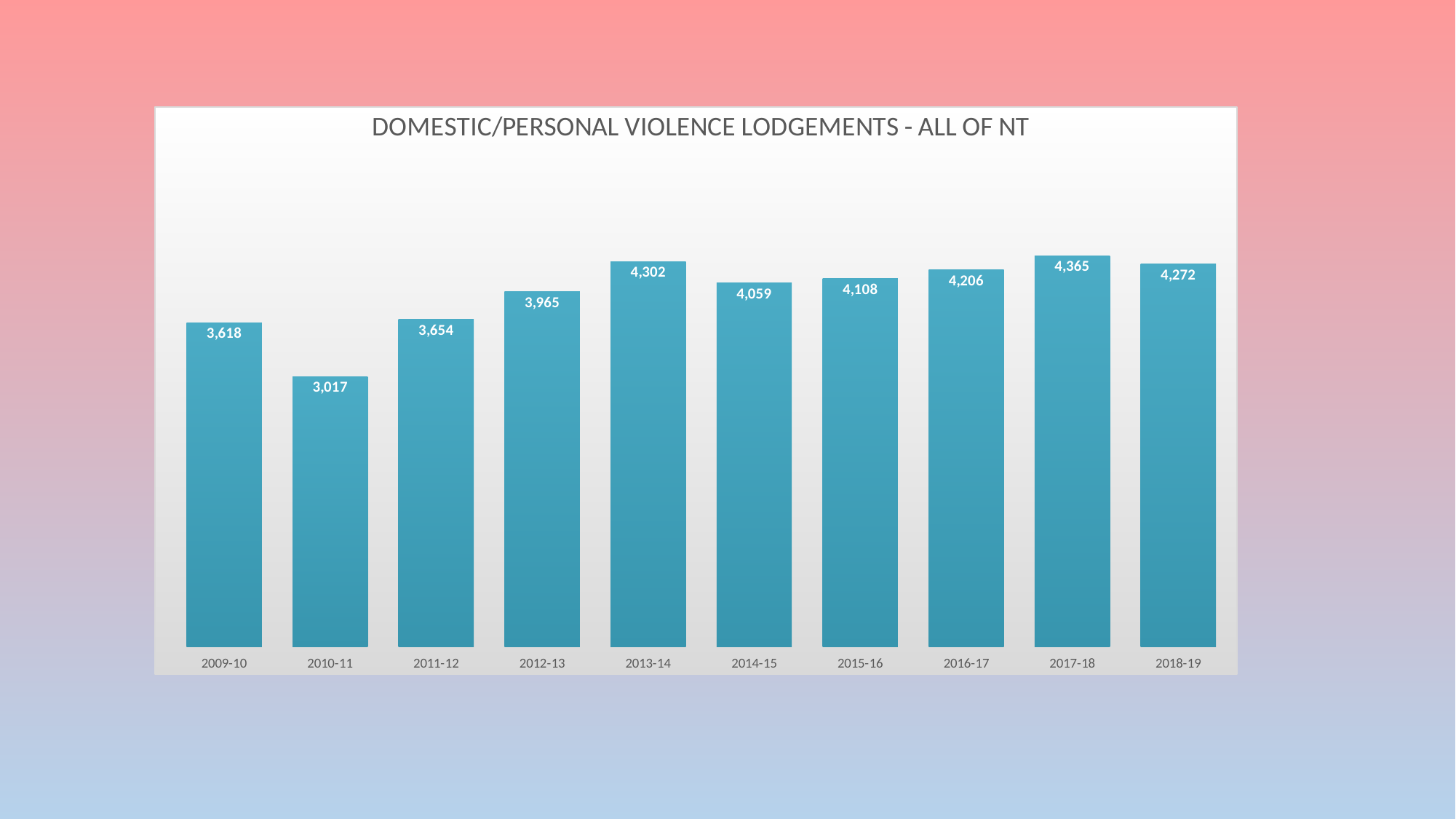
Do the values rise or fall from 2014-15 to 2017-18? rise What is the title of the chart? DOMESTIC/PERSONAL VIOLENCE LODGEMENTS - ALL OF NT Which year has the highest number of lodgements? 2017-18 What is the difference between the values for 2009-10 and 2010-11? 601 How many years are shown on the chart? 10 What is the value for 2018-19? 4,272 What is the difference between the values for 2017-18 and 2018-19? 93 What is the value for 2010-11? 3,017 Which year has the lowest number of lodgements? 2010-11 What kind of chart is this? bar chart What is the value for 2013-14? 4,302 Which is larger, the value for 2013-14 or the value for 2014-15? 2013-14